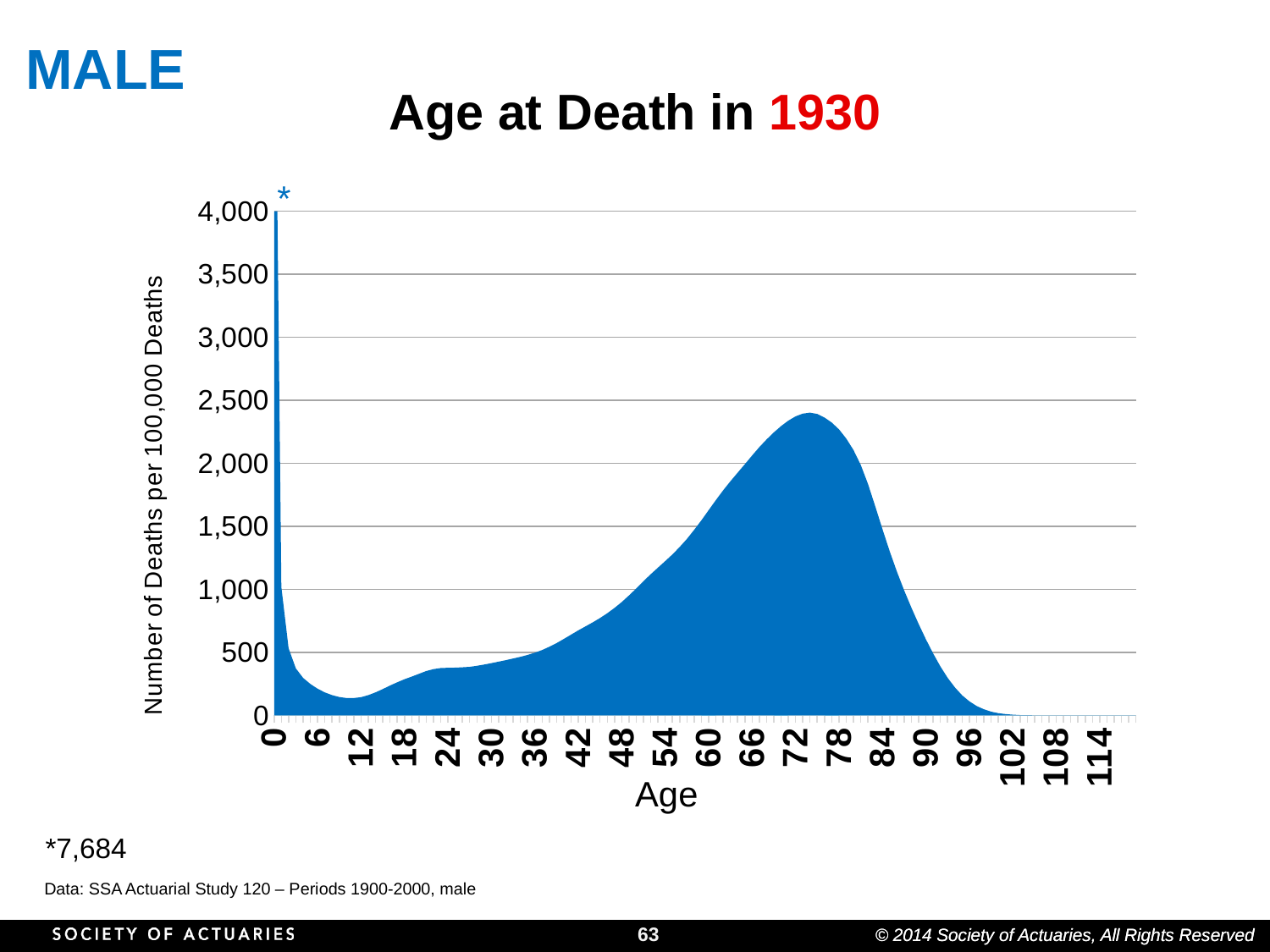
Is the value at age 96 greater or less than 500? less Is the value at age 72 greater or less than 2,000? greater What is the label of the vertical axis? Number of Deaths per 100,000 Deaths Do the values rise or fall between age 36 and age 72? rise Is the value at age 48 greater or less than 1,000? less What is the title of the chart? Age at Death in 1930 What is the value at age 0, as given by the asterisk footnote? 7,684 How many age labels are shown on the horizontal axis? 20 Which has the larger value, age 72 or age 24? age 72 What kind of chart is shown on the slide? area chart At which age is the number of deaths per 100,000 highest? 0